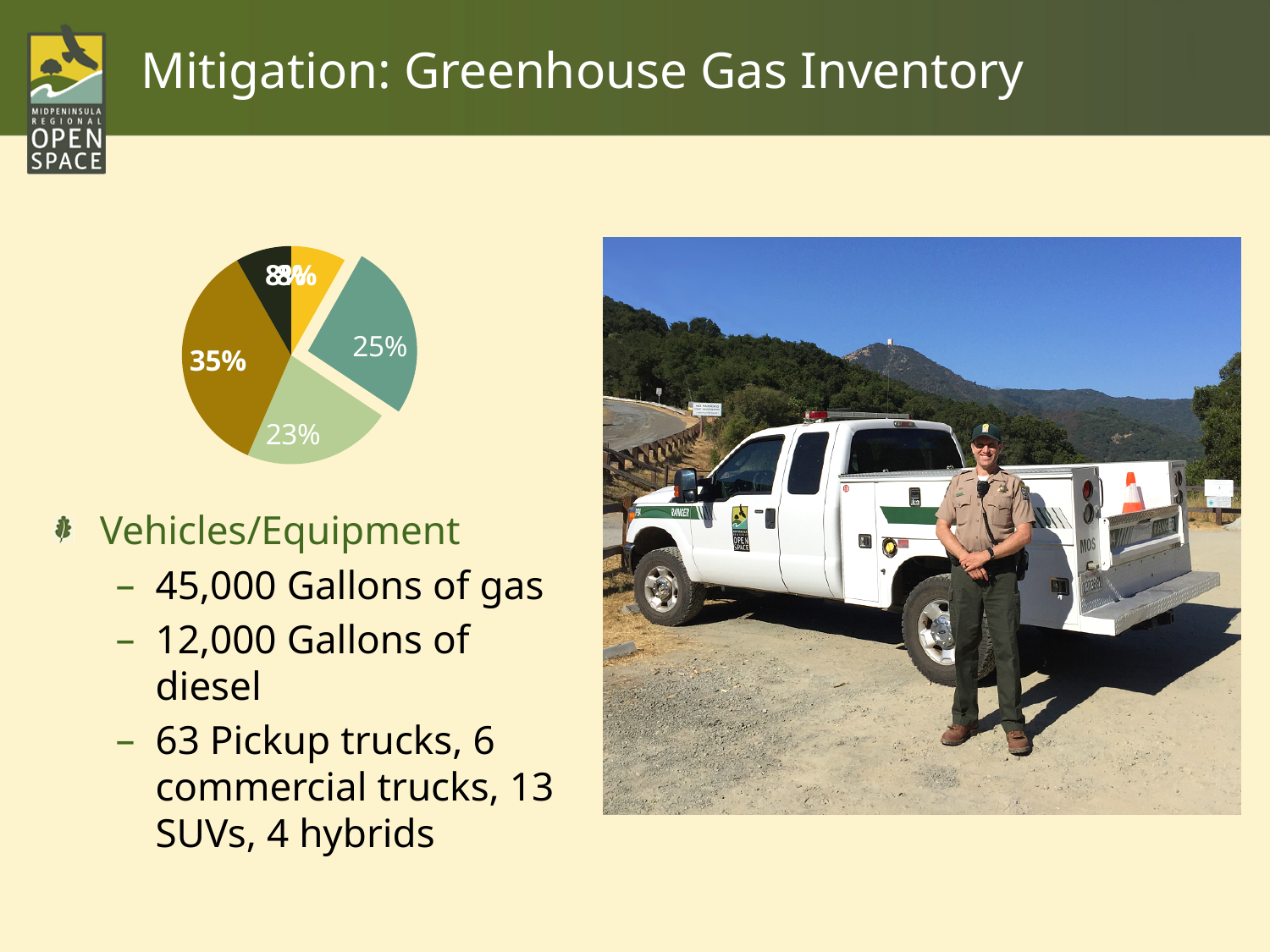
Does the pie chart have a legend? No Does the pie chart have a title? No What is the difference in percentage points between the 35% slice and the 25% slice? 10 Which is larger, the teal slice on the right or the light green slice at the bottom of the pie chart? the teal slice (25%) What is the percentage shown on the olive slice on the left side of the pie chart? 35% What is the percentage shown on the teal slice on the right side of the pie chart? 25% What is the combined share of the 25%, 23% and 35% slices? 83% Is the largest slice of the pie chart greater or less than 30%? greater How many slices does the pie chart have? 5 What kind of chart is shown on the slide? pie chart What is the percentage shown on the light green slice at the bottom of the pie chart? 23% What is the largest percentage labelled on the pie chart? 35%